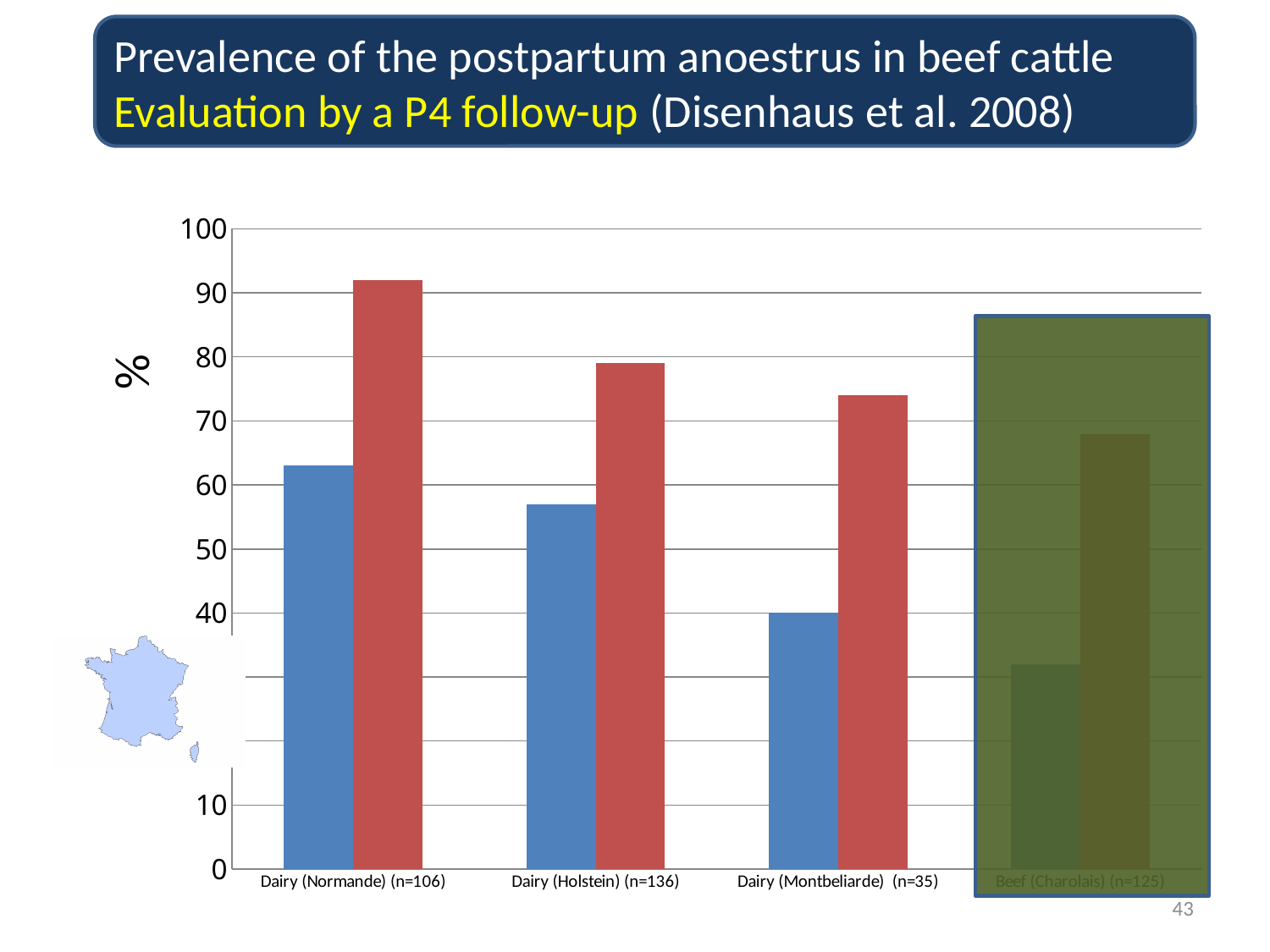
Is the blue bar for Dairy (Montbeliarde) (n=35) greater or less than 50? less Is the red bar for Dairy (Holstein) (n=136) greater or less than 70? greater Do the blue bars rise or fall from left to right across the categories? fall Is the blue bar for Dairy (Normande) (n=106) greater or less than 50? greater Which is larger for Dairy (Holstein) (n=136), the blue bar or the red bar? the red bar What kind of chart is shown on the slide? bar chart Which category has the tallest red bar? Dairy (Normande) (n=106) Which category has the shortest blue bar? Beef (Charolais) (n=125) How many categories are shown on the x axis of the chart? 4 What is the label of the y axis of the chart? %